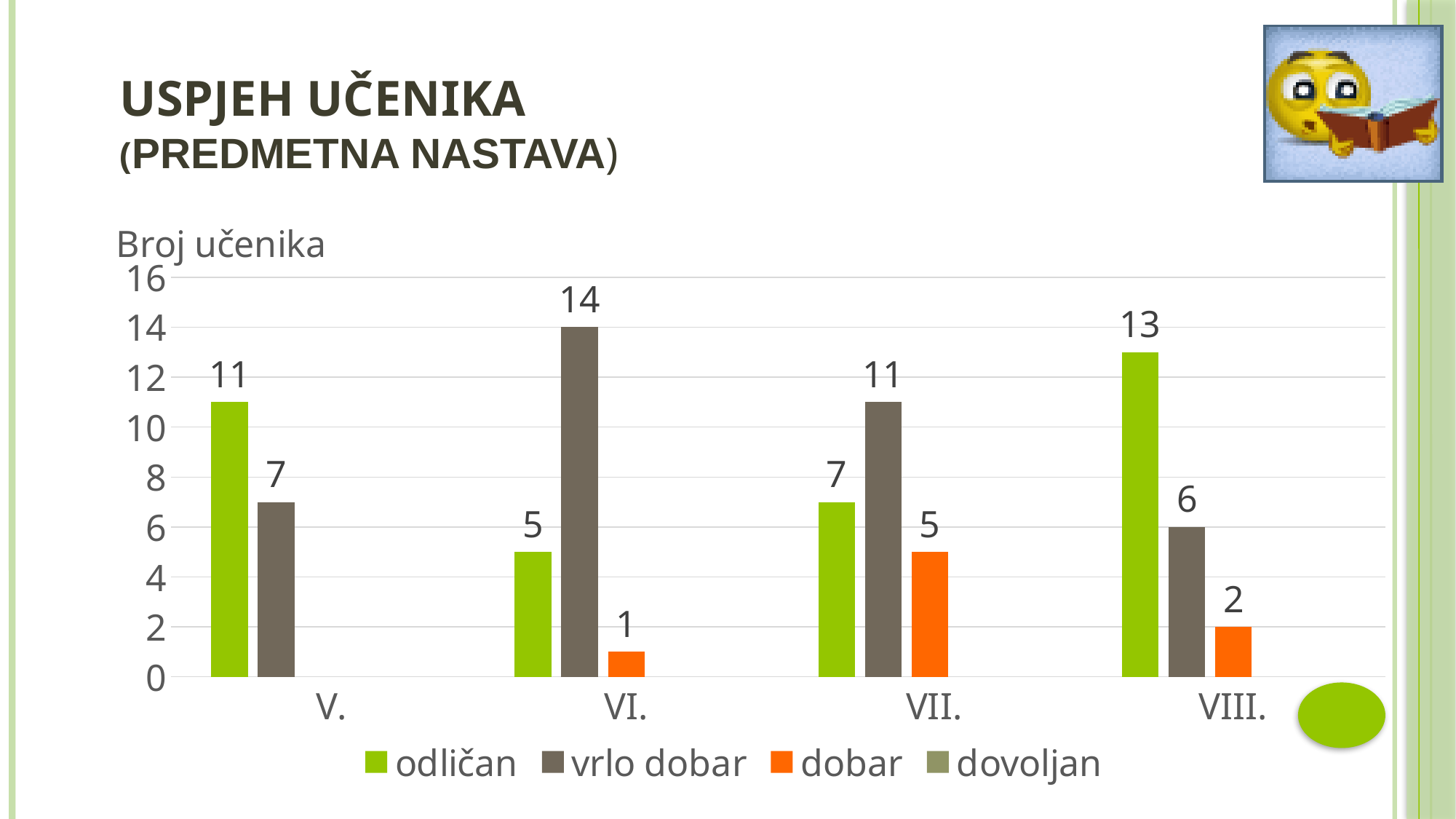
What kind of chart is shown on the slide? bar chart Is the value for vrlo dobar in class VI. greater or less than 12? greater What is the value for dobar in class VIII.? 2 Which class has the highest value for odličan? VIII. Which class has the lowest value for vrlo dobar? VIII. Which is larger in class V.: odličan or vrlo dobar? odličan How many series does the legend list? 4 What is the value for vrlo dobar in class VII.? 11 What is the value for odličan in class VI.? 5 How many classes are shown on the x axis? 4 What is the label of the vertical axis? Broj učenika What is the difference between vrlo dobar and odličan in class VI.? 9